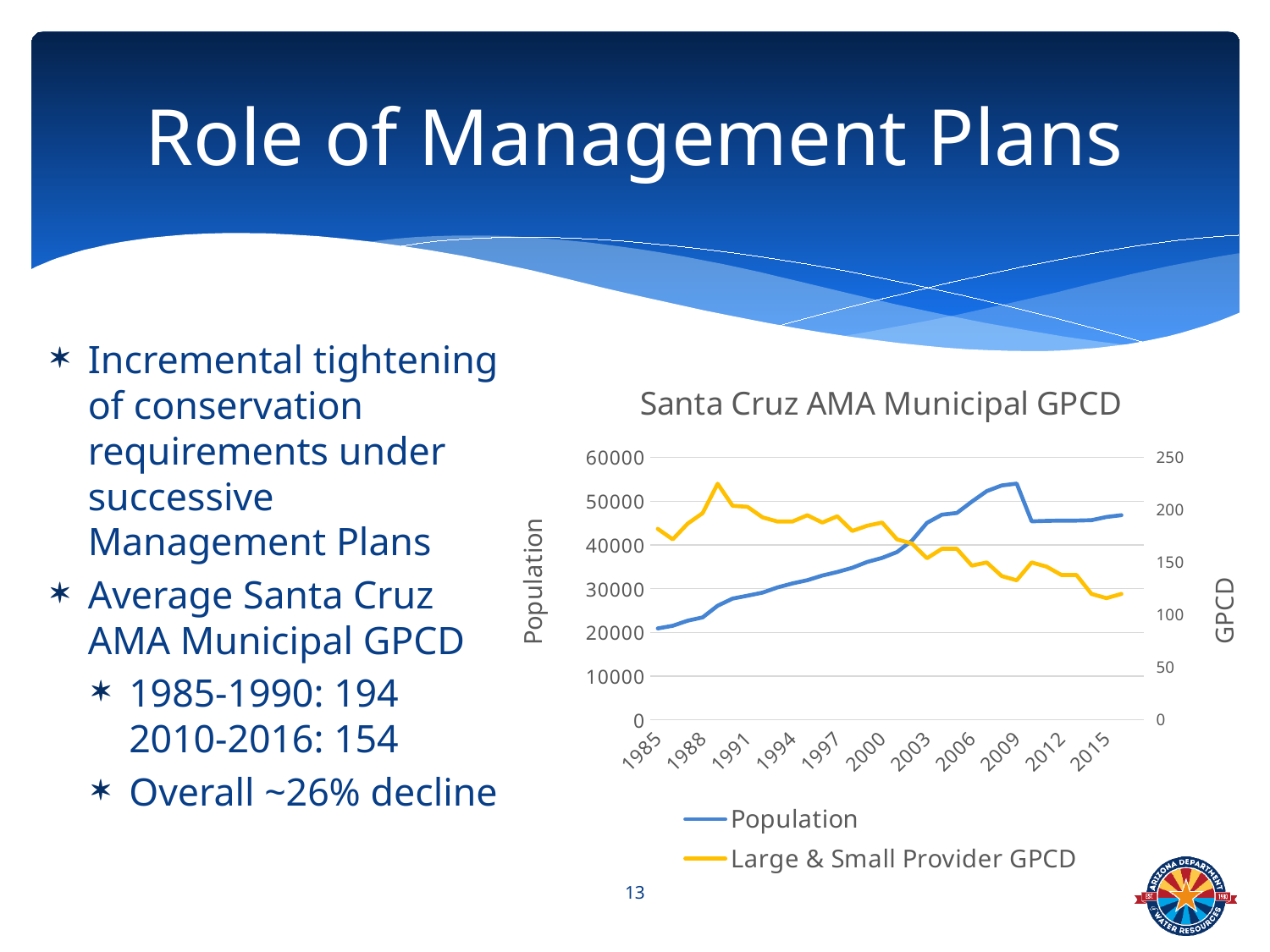
Is the Population value for 1985 greater or less than 30000? less Which year has the higher Large & Small Provider GPCD value, 1990 or 2015? 1990 Is the Large & Small Provider GPCD value for 2015 greater or less than 150? less Is the Large & Small Provider GPCD value for 1985 greater or less than 150? greater Which series is plotted against the right-hand GPCD axis? Large & Small Provider GPCD Does the Large & Small Provider GPCD series generally rise or fall from 1985 to 2015? fall Which year has the higher Population value, 1985 or 2015? 2015 How many series does the legend of the chart list? 2 What kind of chart is shown on the slide? line chart Does the Population series generally rise or fall from 1985 to 2015? rise What is the title of the chart? Santa Cruz AMA Municipal GPCD